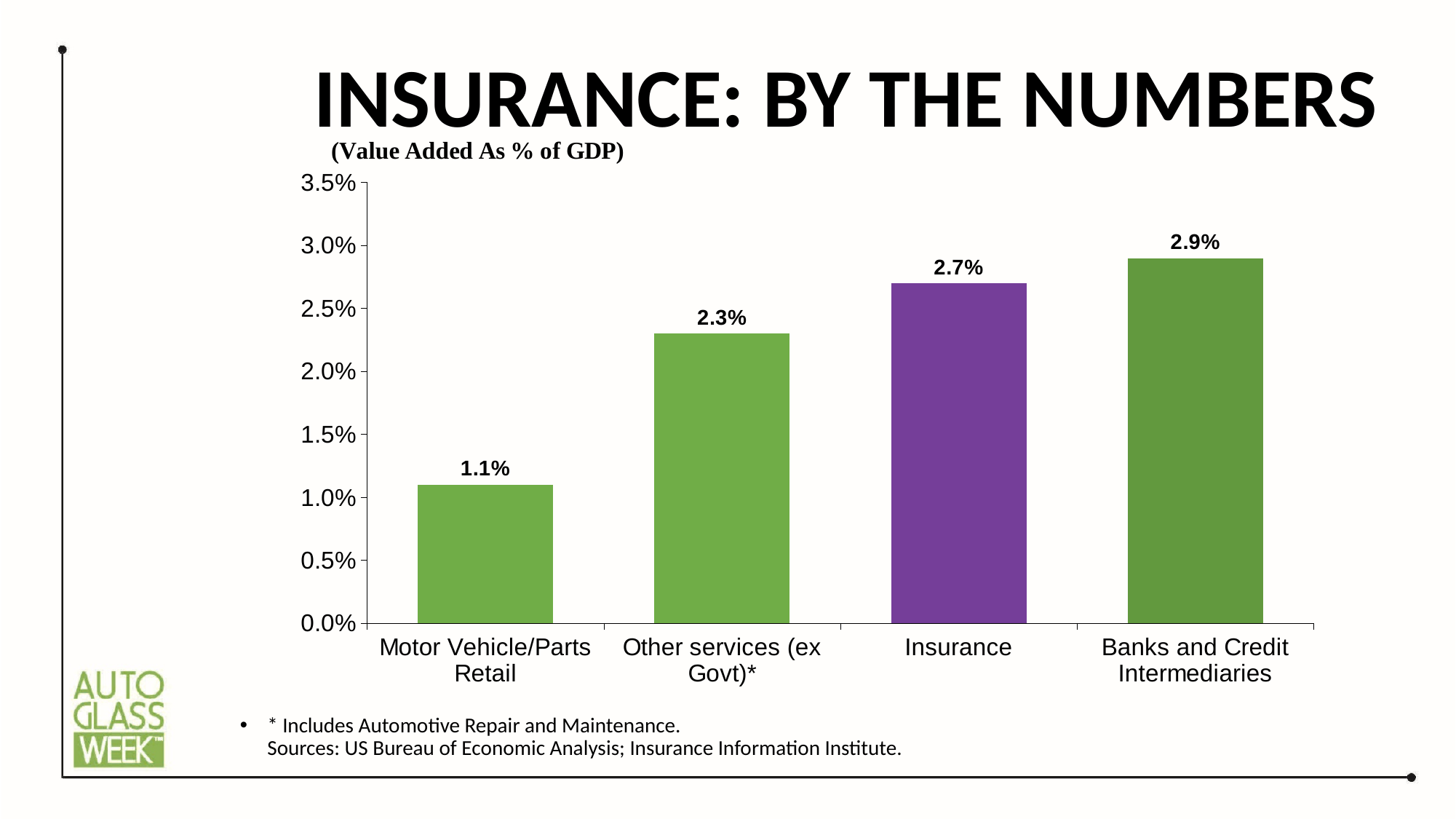
Which category has the lowest value? Motor Vehicle/Parts Retail What is the value for Banks and Credit Intermediaries? 2.9% What is the value for Other services (ex Govt)*? 2.3% What kind of chart is shown on the slide? bar chart What is the difference between the values for Banks and Credit Intermediaries and Insurance? 0.2% Which category has the highest value? Banks and Credit Intermediaries What is the value for Motor Vehicle/Parts Retail? 1.1% How many categories are shown on the chart? 4 What is the value for Insurance? 2.7% Is the value for Motor Vehicle/Parts Retail greater or less than 1.5%? less Which is larger, the value for Insurance or the value for Other services (ex Govt)*? Insurance Which bar is coloured purple rather than green? Insurance